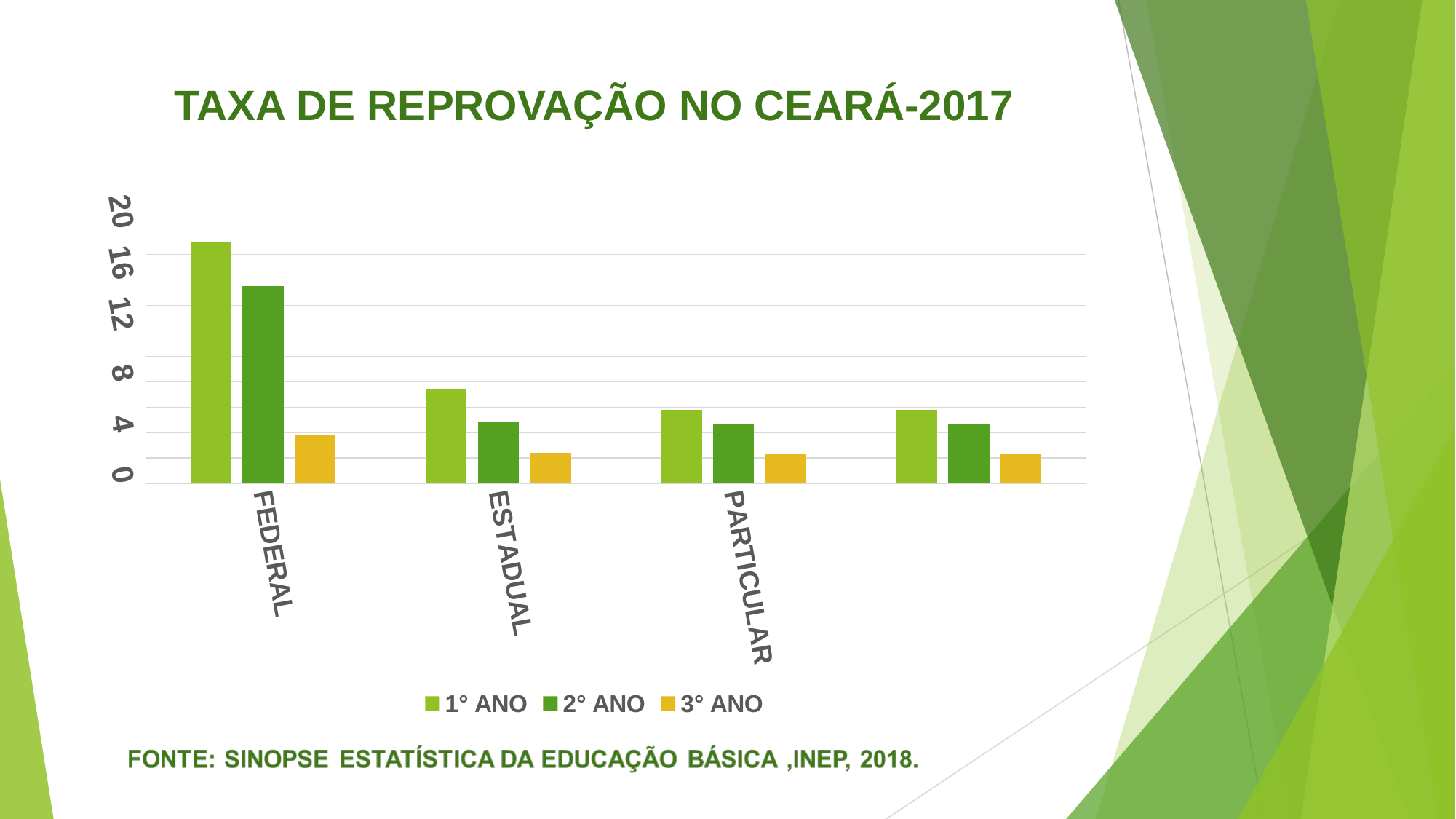
What is the title of the chart? TAXA DE REPROVAÇÃO NO CEARÁ-2017 Is the 1° ANO value for ESTADUAL greater or less than 8? less For FEDERAL, which series has the larger value, 1° ANO or 3° ANO? 1° ANO Is the 3° ANO value for PARTICULAR greater or less than 4? less What kind of chart is shown on the slide? bar chart Which is larger, the 1° ANO value for FEDERAL or the 1° ANO value for ESTADUAL? FEDERAL Is the 2° ANO value for FEDERAL greater or less than 12? greater Which category has the highest value for 1° ANO? FEDERAL What are the three series named in the legend? 1° ANO, 2° ANO, 3° ANO How many series does the legend list? 3